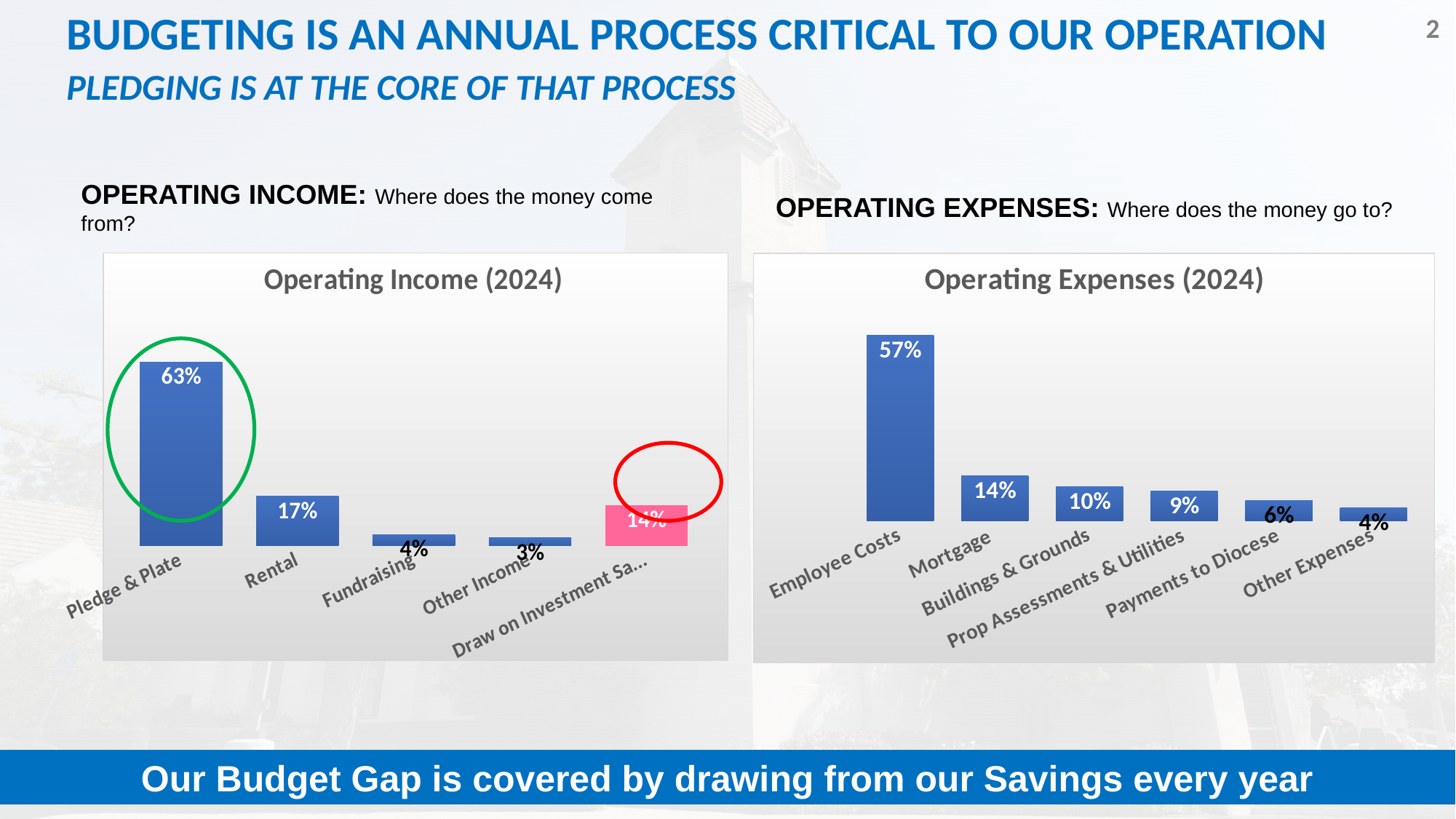
In the Operating Expenses (2024) chart, which is larger, Mortgage or Buildings & Grounds? Mortgage In the Operating Income (2024) chart, what is the value for Pledge & Plate? 63% In the Operating Income (2024) chart, what is the difference between Pledge & Plate and Rental? 46% In the Operating Income (2024) chart, how many categories are shown? 5 In the Operating Income (2024) chart, what is the value for Rental? 17% In the Operating Expenses (2024) chart, which category has the highest value? Employee Costs In the Operating Expenses (2024) chart, how many categories are shown? 6 In the Operating Income (2024) chart, which category has the lowest value? Other Income In the Operating Expenses (2024) chart, what is the value for Payments to Diocese? 6% In the Operating Expenses (2024) chart, what is the value for Employee Costs? 57% In the Operating Income (2024) chart, what is the value of the pink bar? 14% What type of chart is the Operating Expenses (2024) chart? Bar chart